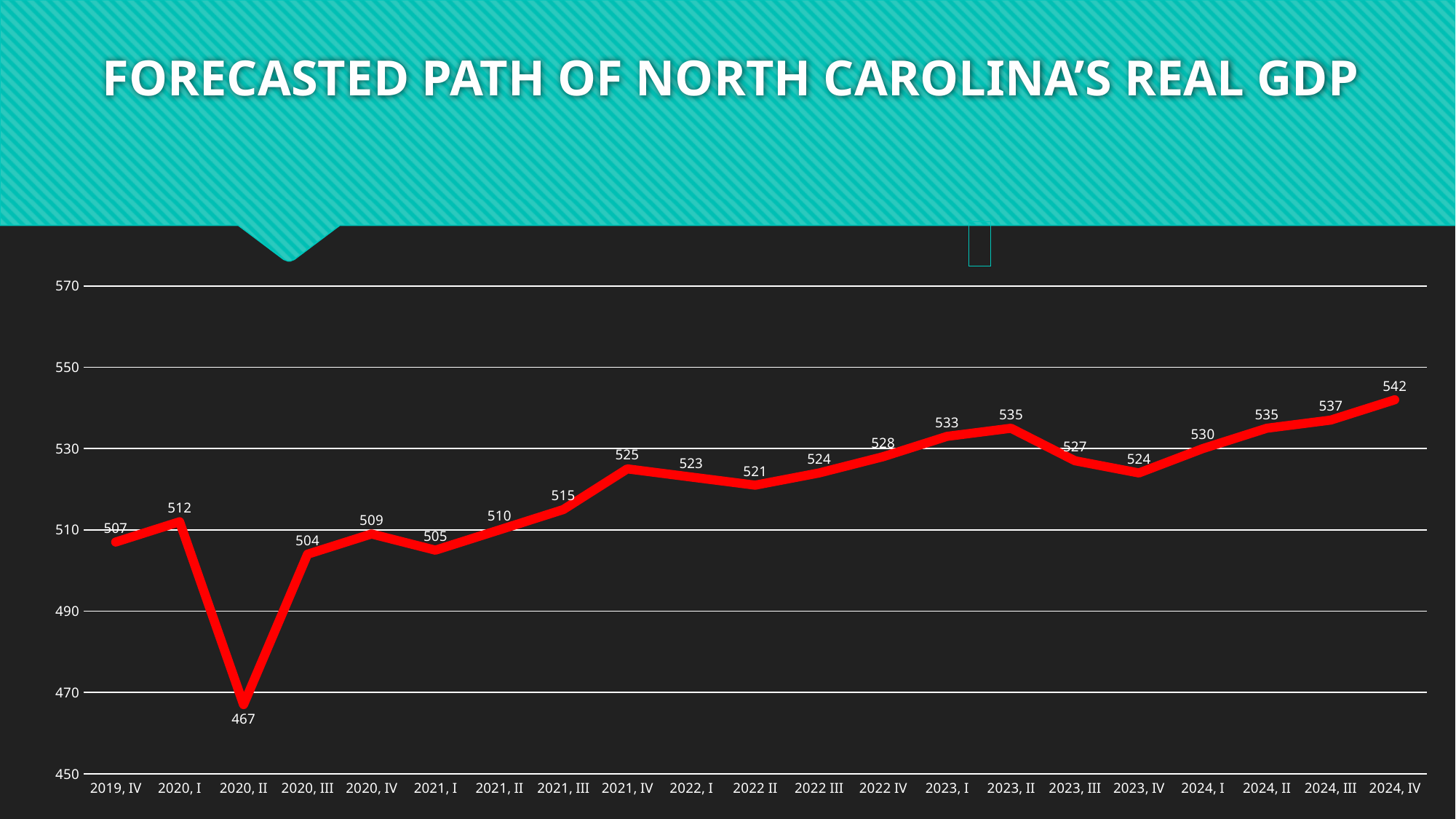
How many quarters are plotted on the x axis? 21 What is the value plotted for 2024, IV? 542 Which quarter has the lowest value on the chart? 2020, II Which quarter has the highest value on the chart? 2024, IV What type of chart is shown on the slide? line chart What is the difference between the values for 2024, IV and 2019, IV? 35 What is the title of the chart? FORECASTED PATH OF NORTH CAROLINA'S REAL GDP What is the difference between the values for 2020, I and 2020, II? 45 From 2023, IV to 2024, IV, do the values rise or fall? rise Which is larger, the value for 2023, II or the value for 2023, IV? 2023, II What is the value plotted for 2021, IV? 525 What is the forecasted real GDP value for 2020, II? 467